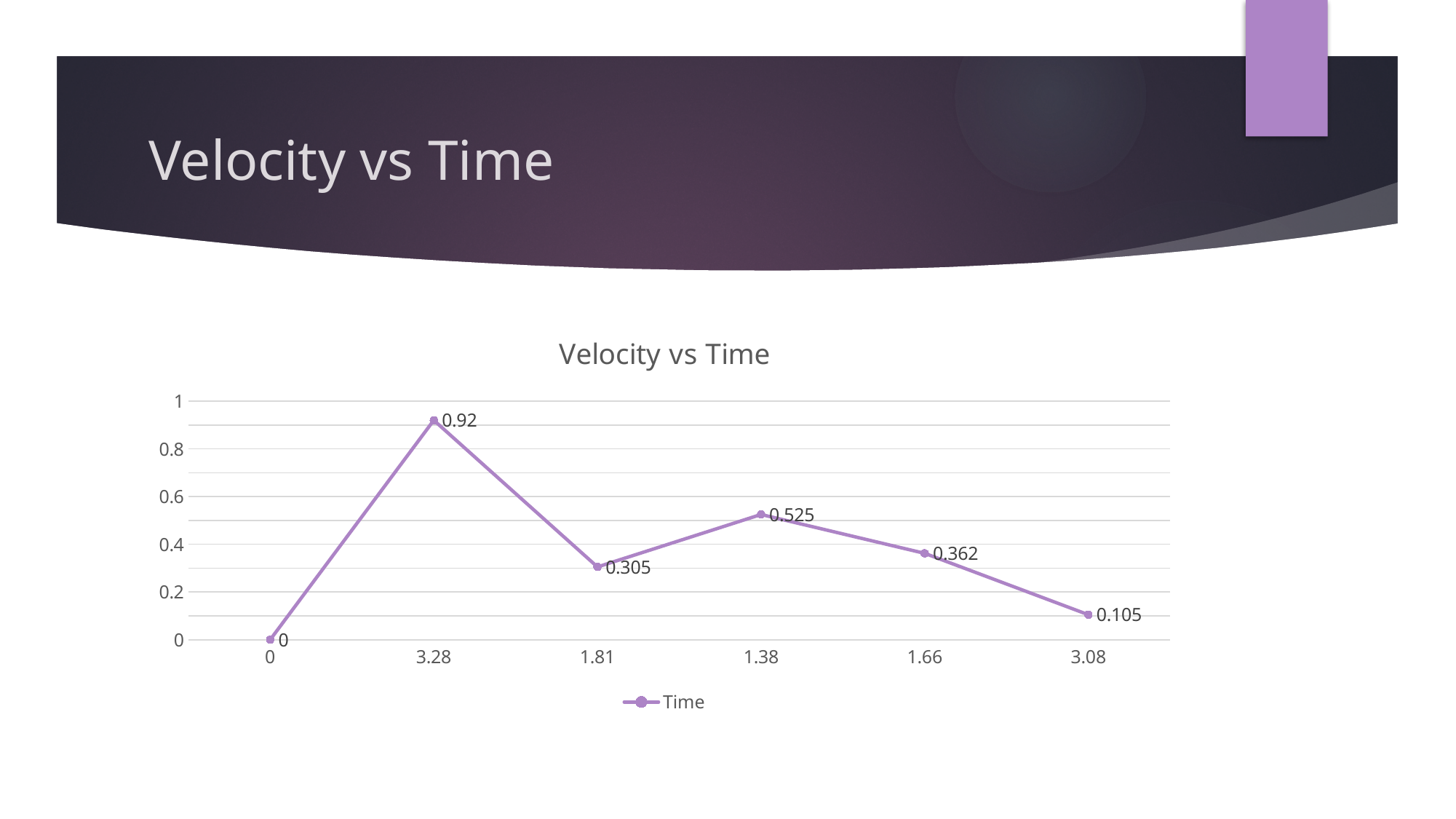
What is the title of the chart? Velocity vs Time What kind of chart is shown? line chart What is the value at the x-axis category 3.08? 0.105 Which has a larger value, the point at 1.38 or the point at 1.66? 1.38 Which x-axis category has the highest value? 3.28 What is the value at the x-axis category 3.28? 0.92 Is the value at 1.66 greater or less than 0.4? less How many data points are plotted on the chart? 6 How many series does the legend list? 1 Which x-axis category has the lowest value? 0 What is the difference between the values at 3.28 and 1.81? 0.615 What is the value at the x-axis category 1.81? 0.305